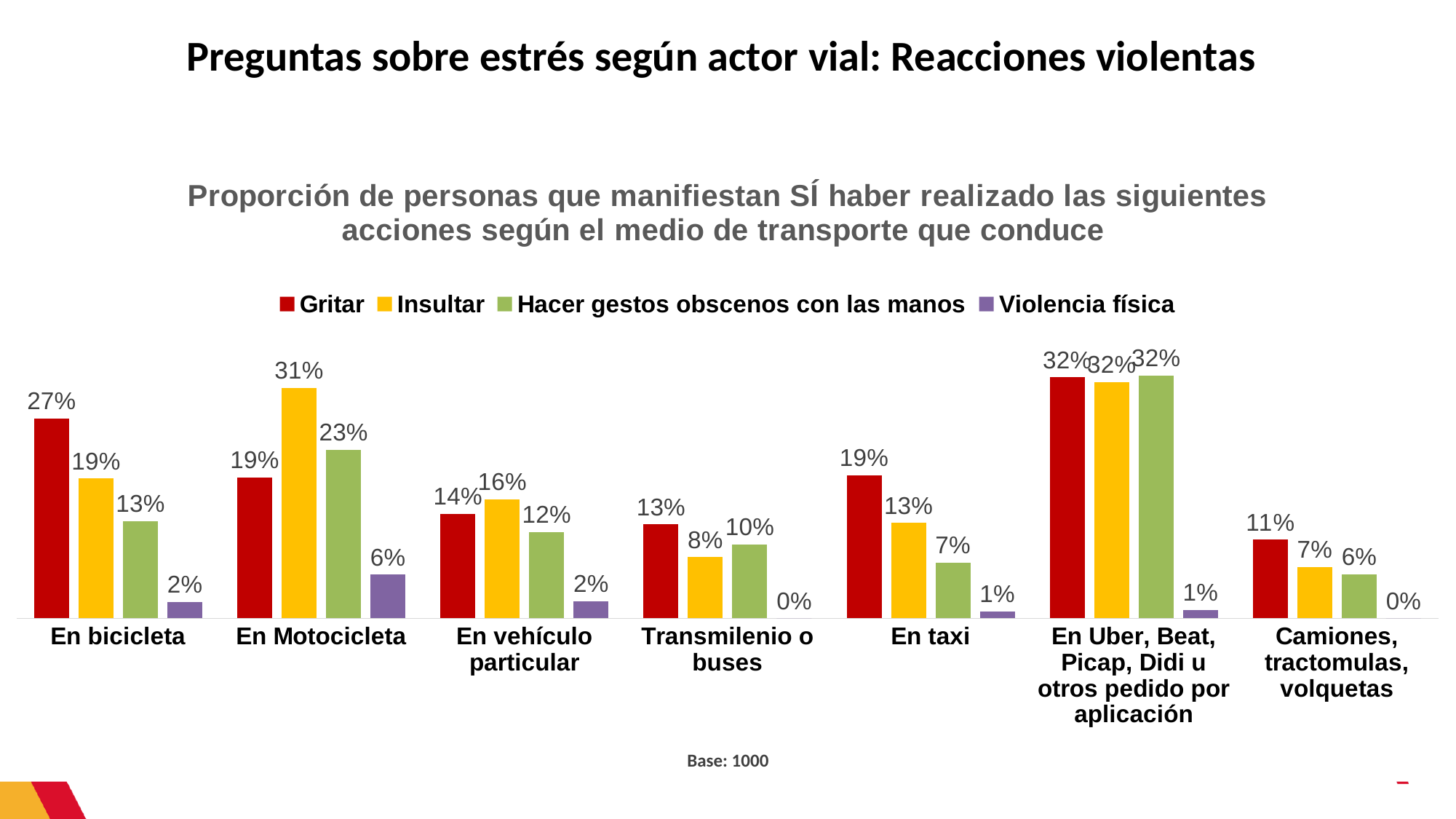
What is the value for Insultar in the En Motocicleta category? 31% What is the difference between the Gritar values for En bicicleta and En taxi? 8% How many series does the legend list? 4 What is the value for Hacer gestos obscenos con las manos in the Transmilenio o buses category? 10% Which category has the lowest value for Insultar? Camiones, tractomulas, volquetas Which is larger: the Insultar value for En Motocicleta or the Insultar value for En vehículo particular? En Motocicleta What is the value for Violencia física in the En Motocicleta category? 6% What is the value for Gritar in the En bicicleta category? 27% What is the base (sample size) noted below the chart? Base: 1000 How many transport categories are shown on the x axis? 7 Which category has the highest value for Gritar? En Uber, Beat, Picap, Didi u otros pedido por aplicación What kind of chart is shown on the slide? Bar chart